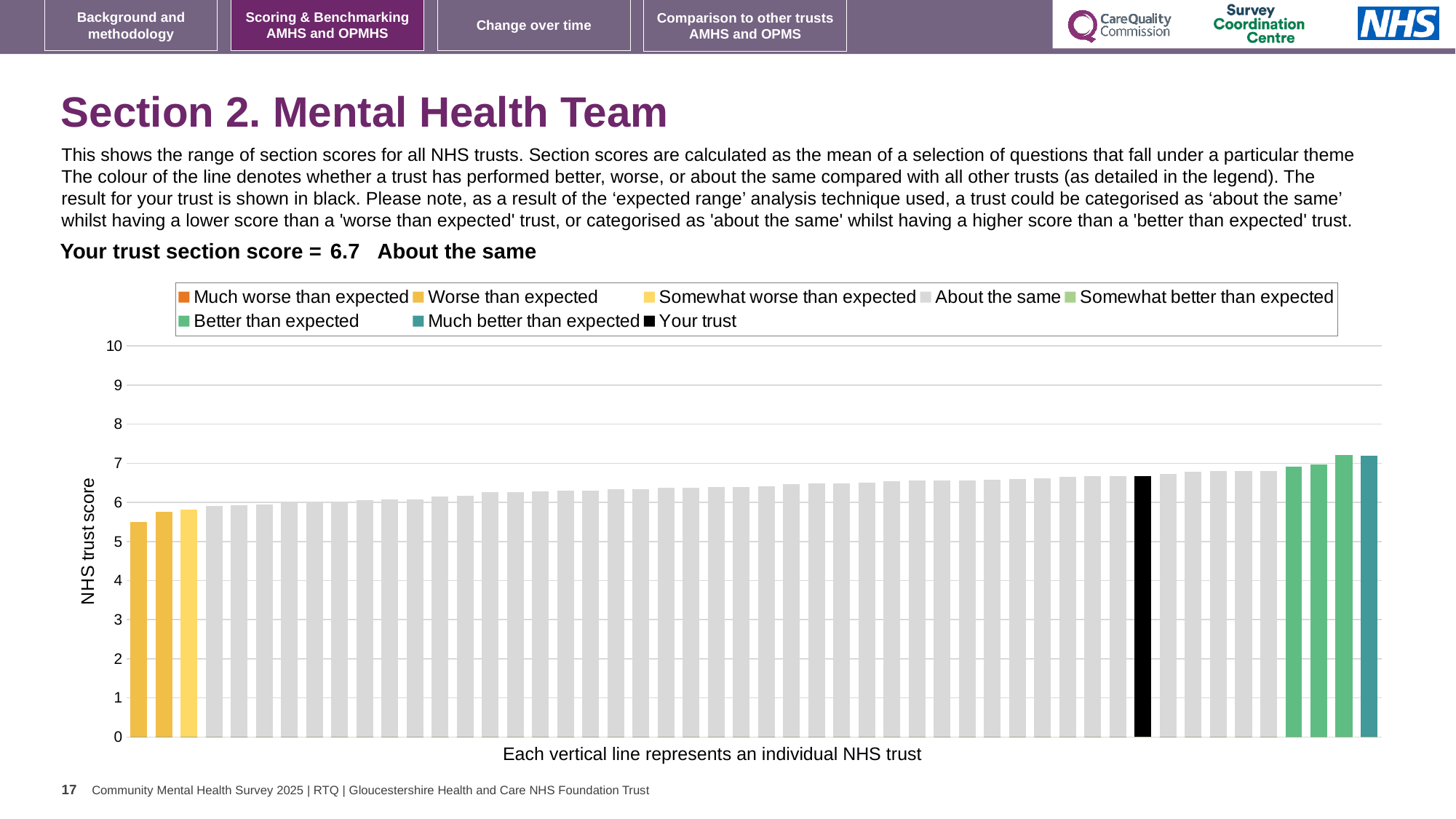
What is the section score for your trust shown on the slide? 6.7 Is the value of the black bar (your trust) greater or less than 6? greater Is the value of the leftmost (lowest) bar greater or less than 6? less How many entries does the chart legend list? 8 What is the label on the vertical axis of the chart? NHS trust score Which category is your trust placed in for this section score? About the same Is the value of the black bar (your trust) greater or less than 7? less Do the bar values rise or fall from left to right along the x axis? rise How many bars are coloured as 'Worse than expected' (dark yellow)? 2 How many bars are coloured as 'Much better than expected' (teal)? 1 What kind of chart is shown on the slide? bar chart